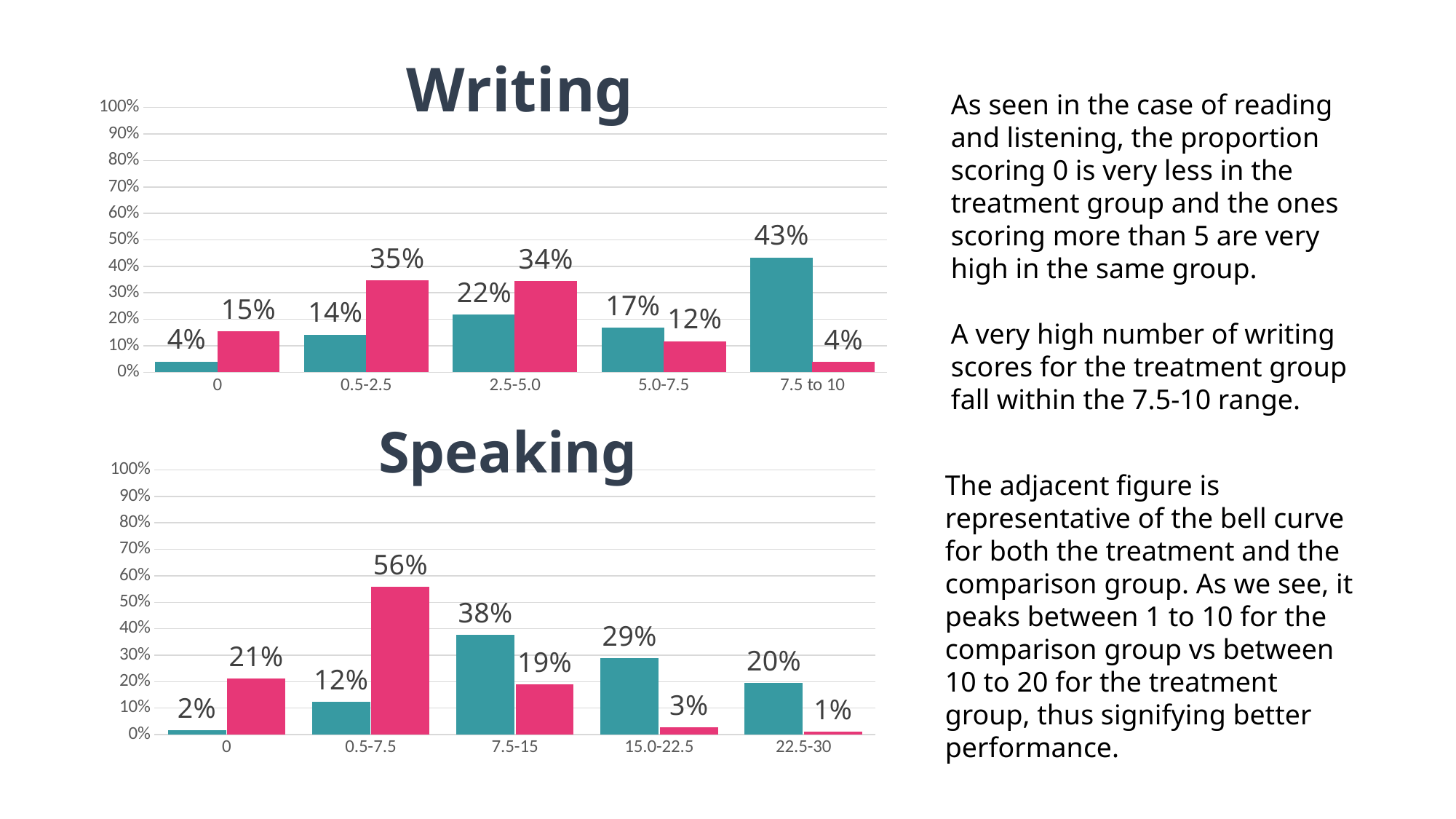
In the Speaking chart, what is the difference between the pink and teal bars for the 0.5-7.5 category? 44% In the Writing chart, what is the value of the pink bar for the 0.5-2.5 category? 35% In the Speaking chart, is the value of the pink bar for 0.5-7.5 greater or less than 50%? greater In the Speaking chart, what is the value of the pink bar for the 0.5-7.5 category? 56% In the Writing chart, which is larger for the 2.5-5.0 category, the teal bar or the pink bar? the pink bar In the Speaking chart, which category has the lowest pink bar? 22.5-30 How many categories are shown on the x axis of the Speaking chart? 5 In the Writing chart, what is the difference between the teal and pink bars for the 7.5 to 10 category? 39% In the Speaking chart, what is the value of the teal bar for the 15.0-22.5 category? 29% In the Writing chart, what is the value of the teal bar for the 7.5 to 10 category? 43% What kind of chart is the Writing chart? bar chart In the Writing chart, which category has the highest teal bar? 7.5 to 10